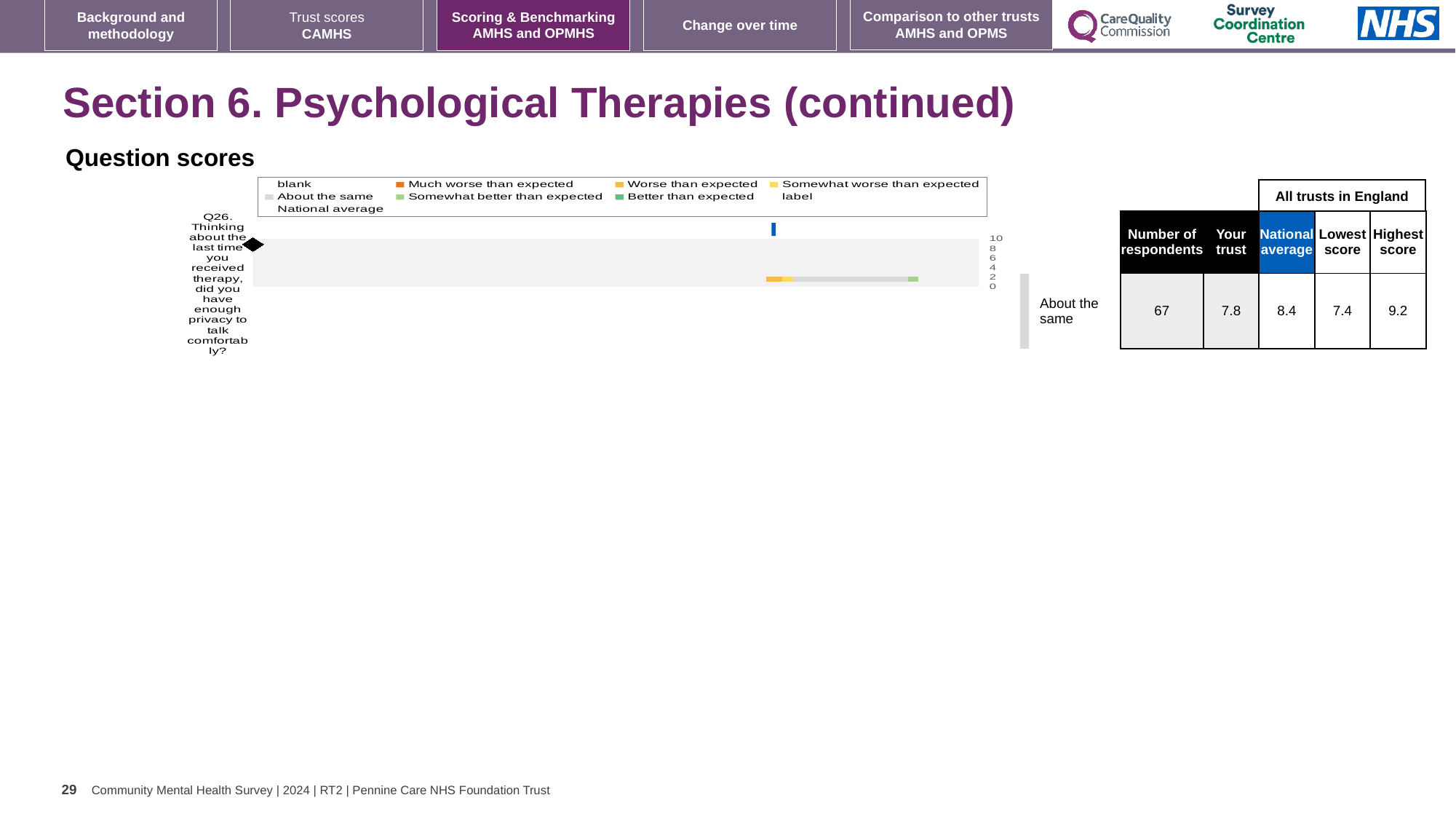
What benchmark category is shown for Q26 next to the chart? About the same Which is larger for Q26, the trust score or the national average? national average What is the national average score for Q26? 8.4 What kind of chart is shown under 'Question scores'? bar chart What is the difference between the national average and the trust score for Q26? 0.6 How many survey questions are plotted in the Question scores chart? 1 How many entries does the legend of the Question scores chart list? 9 How many respondents answered Q26? 67 What is the 'Your trust' score for Q26? 7.8 What is the lowest score among all trusts in England for Q26? 7.4 Which survey question is plotted in the Question scores chart? Q26 What is the highest score among all trusts in England for Q26? 9.2